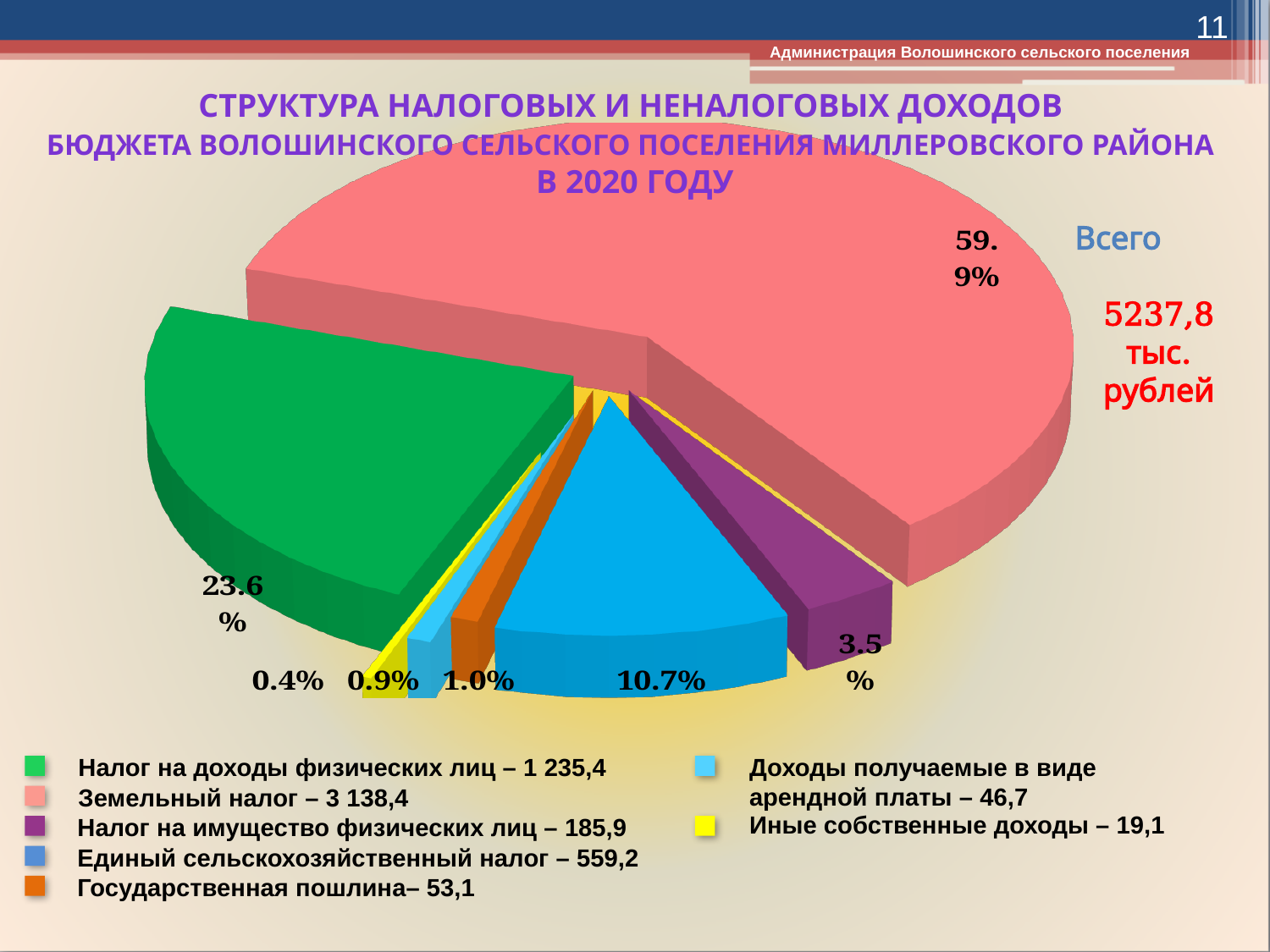
What value is given in the legend for Государственная пошлина? 53,1 What share of the pie does Земельный налог take? 59.9% Which category has the largest share of the pie? Земельный налог What value is given in the legend for Доходы получаемые в виде арендной платы? 46,7 What kind of chart is shown on the slide? pie chart What share of the pie does Налог на доходы физических лиц take? 23.6% What is the difference between the legend values for Земельный налог and Налог на доходы физических лиц? 1 903,0 Which is larger: Налог на имущество физических лиц or Единый сельскохозяйственный налог? Единый сельскохозяйственный налог Which category has the smallest share of the pie? Иные собственные доходы What share of the pie does Единый сельскохозяйственный налог take? 10.7% How many slices does the pie chart have? 7 What total (Всего) is shown next to the pie chart? 5237,8 тыс. рублей